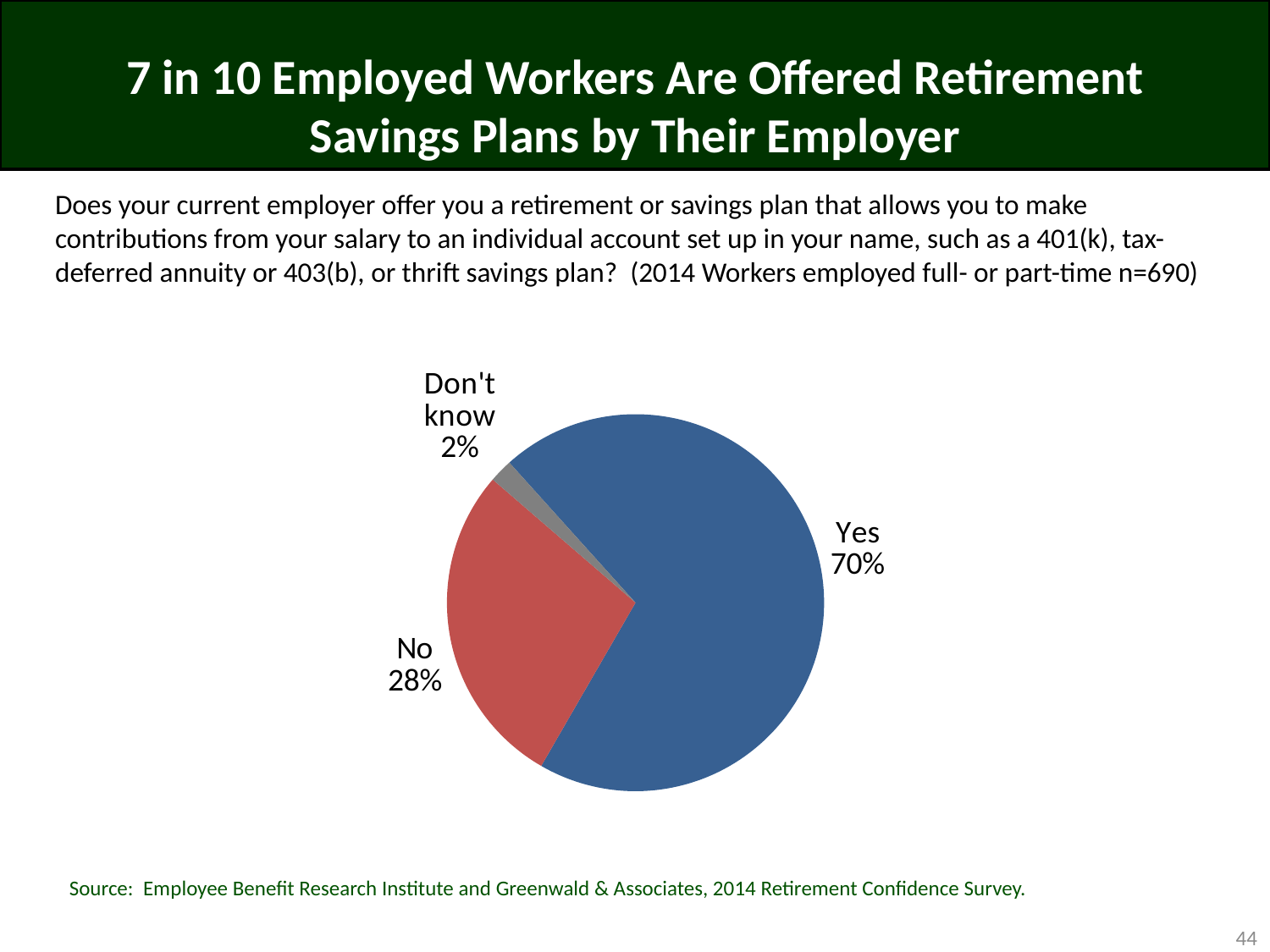
What is the difference in percentage points between the "Yes" and "No" slices? 42 Which response has the smallest share of the pie? Don't know What percentage of workers answered "No"? 28% What percentage of workers answered "Don't know"? 2% What colour is the "Yes" slice? blue Which is larger, the "No" slice or the "Don't know" slice? No What percentage of workers answered "Yes"? 70% What share of the pie does the "Yes" slice represent? 70% How many slices does the pie chart have? 3 Which response has the largest share of the pie? Yes What is the sample size (n) stated in the question text above the chart? 690 What kind of chart is shown on the slide? pie chart